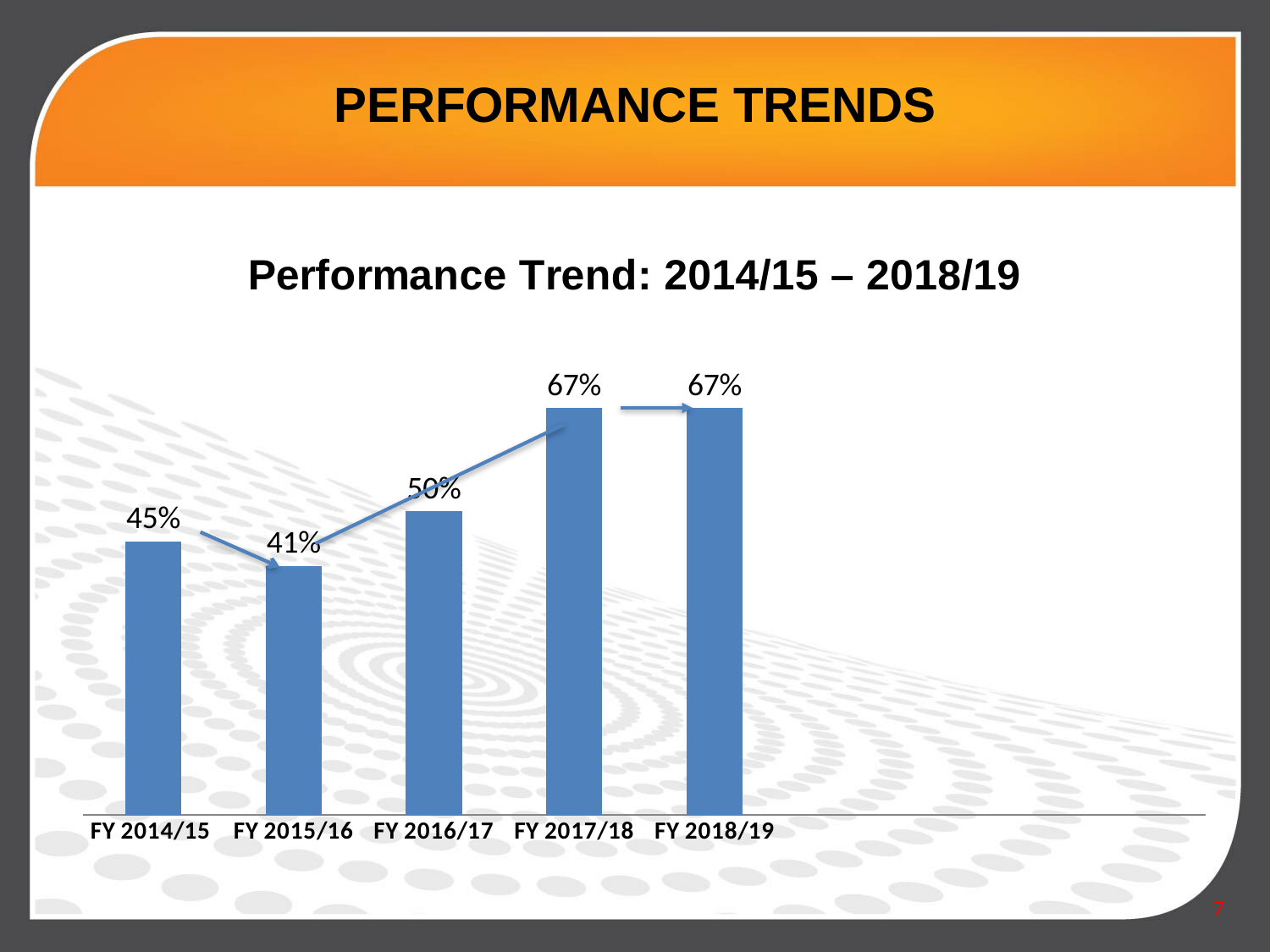
What is the difference between the values for FY 2017/18 and FY 2016/17? 17% What kind of chart is shown on the slide? Bar chart How many fiscal years are shown on the chart? 5 What is the title of the chart? Performance Trend: 2014/15 – 2018/19 What is the value for FY 2014/15? 45% What is the difference between the values for FY 2014/15 and FY 2015/16? 4% What is the value for FY 2017/18? 67% What is the value for FY 2015/16? 41% Which fiscal year has the lowest value? FY 2015/16 What is the value for FY 2016/17? 50% Do the values rise or fall from FY 2015/16 to FY 2017/18? Rise Which is larger, the value for FY 2014/15 or FY 2016/17? FY 2016/17